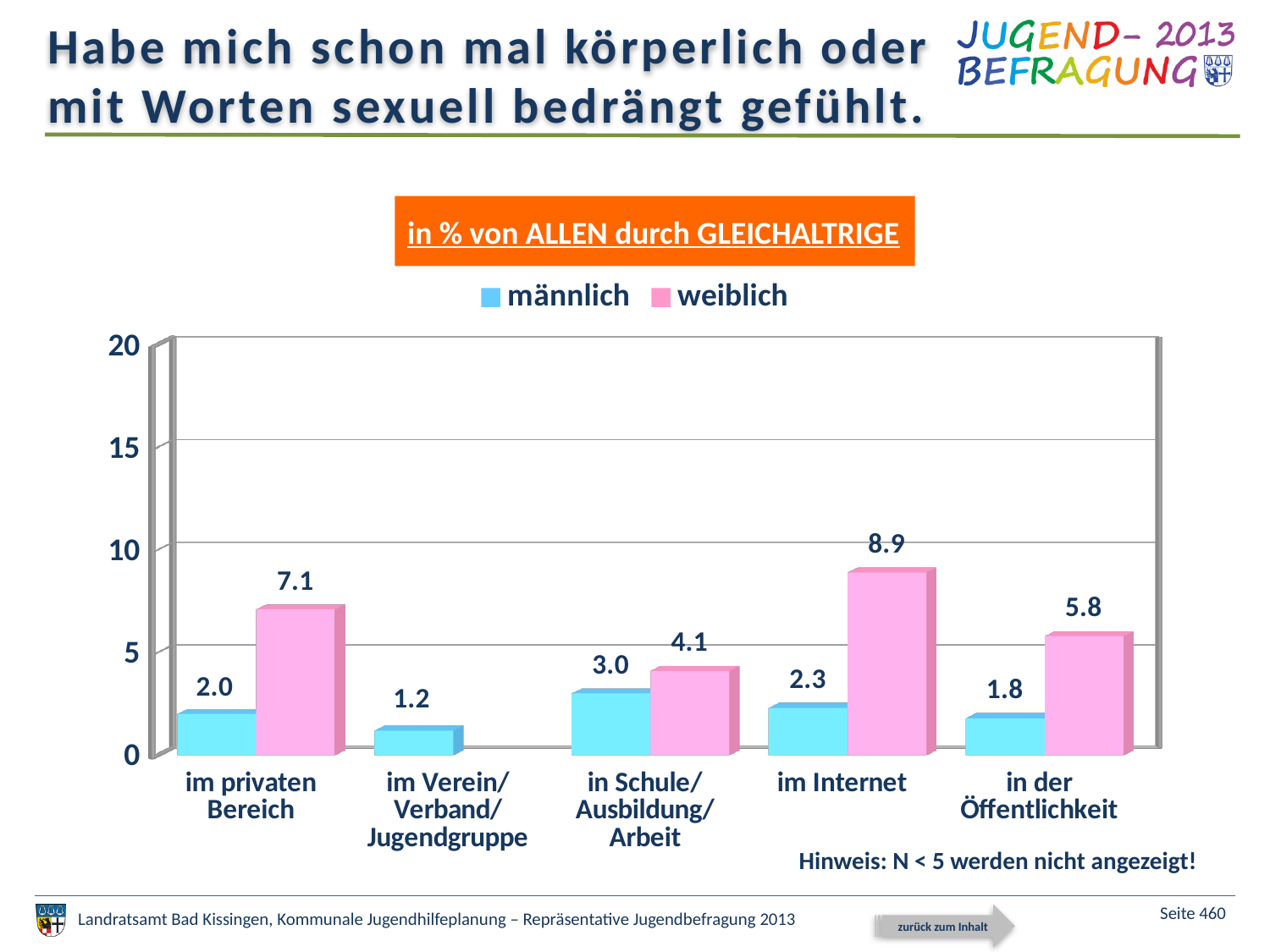
What is the difference between the weiblich and männlich values in the category 'im privaten Bereich'? 5.1 How many categories are shown on the x axis? 5 What is the value for weiblich in the category 'in der Öffentlichkeit'? 5.8 Is the weiblich value for 'im Internet' greater or less than 5? greater In which category is the weiblich value highest? im Internet What is the value for weiblich in the category 'im Internet'? 8.9 What is the value for männlich in the category 'im Verein/Verband/Jugendgruppe'? 1.2 What kind of chart is shown on the slide? bar chart How many series does the legend list? 2 In which category is the männlich value lowest? im Verein/Verband/Jugendgruppe Which is larger in the category 'in Schule/Ausbildung/Arbeit': the männlich value or the weiblich value? weiblich What is the value for männlich in the category 'im privaten Bereich'? 2.0